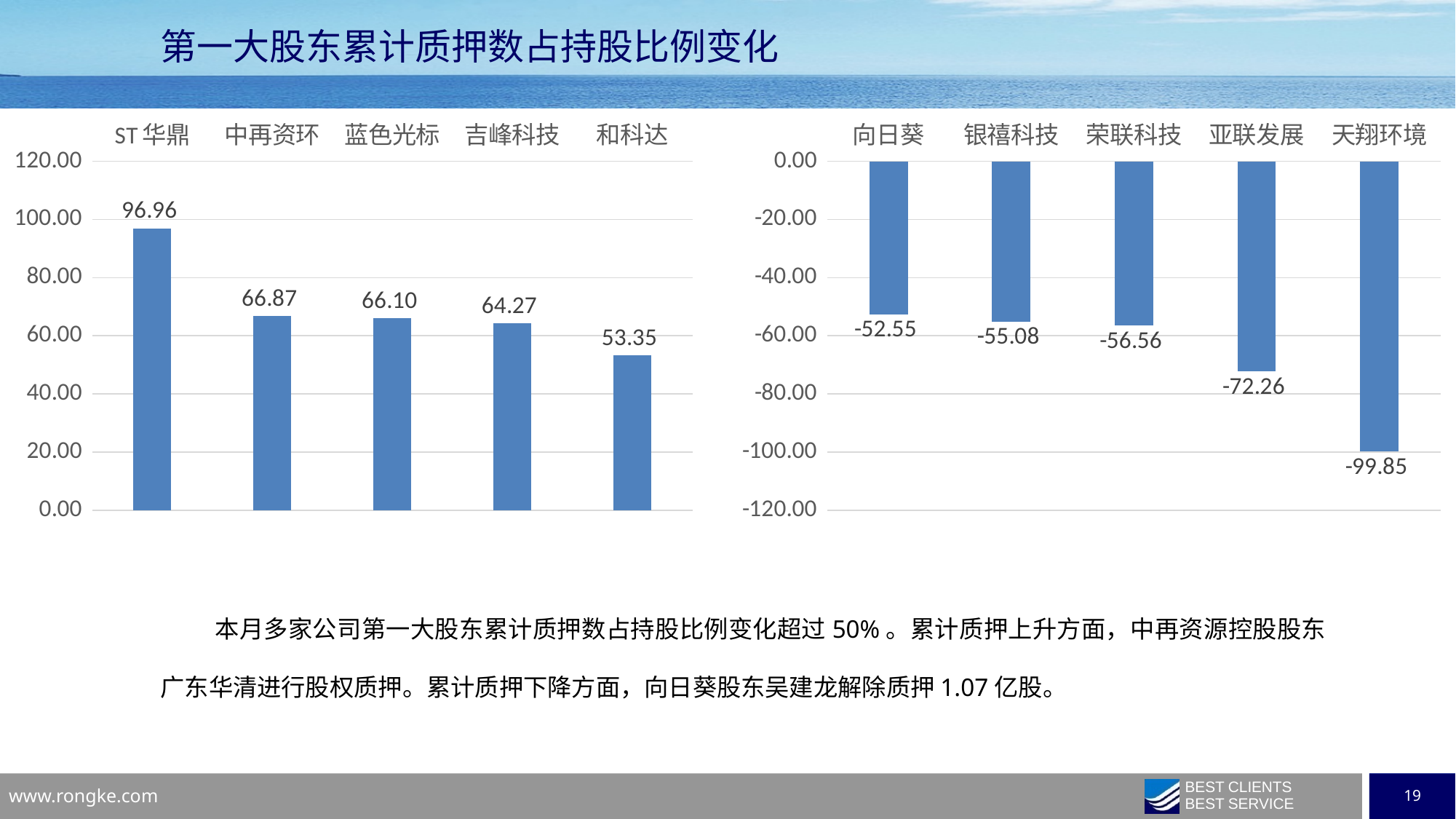
In the right chart, which category has the lowest value? 天翔环境 In the right chart, what is the value for 向日葵? -52.55 In the left chart, what is the value for ST 华鼎? 96.96 In the left chart, what is the value for 和科达? 53.35 In the left chart, what is the difference between the values for ST 华鼎 and 中再资环? 30.09 In the right chart, what is the value for 亚联发展? -72.26 In the right chart, what is the difference between the values for 向日葵 and 天翔环境? 47.30 In the left chart, which is larger, the value for 蓝色光标 or the value for 吉峰科技? 蓝色光标 In the left chart, which category has the highest value? ST 华鼎 What kind of chart is the left chart? Bar chart In the left chart, which category has the lowest value? 和科达 How many categories are shown in the right chart? 5